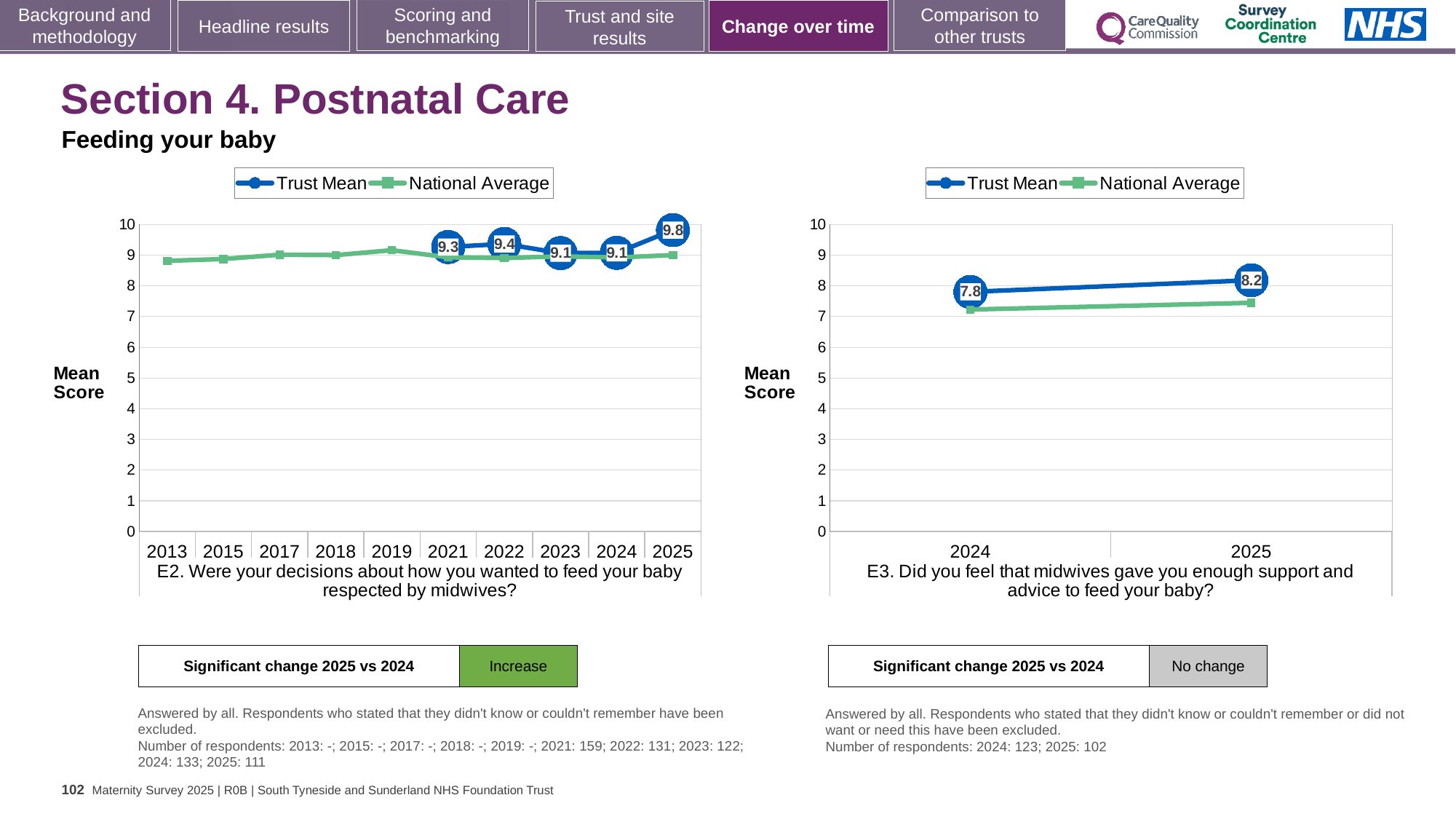
In the left chart (E2), which year has the highest Trust Mean? 2025 How many years are shown on the x axis of the left chart (E2)? 10 In the left chart (E2), what is the Trust Mean for 2025? 9.8 In the left chart (E2), what is the Trust Mean for 2021? 9.3 How many series does the legend of the right chart (E3) list? 2 In the right chart (E3), what is the difference between the Trust Mean in 2025 and in 2024? 0.4 In the right chart (E3), is the National Average for 2024 greater or less than 8? less In the right chart (E3), what is the Trust Mean for 2024? 7.8 In the left chart (E2), what is the difference between the Trust Mean in 2025 and in 2024? 0.7 What kind of chart is the right chart (E3)? Line chart In the right chart (E3), does the Trust Mean rise or fall from 2024 to 2025? Rise In the left chart (E2), which is larger, the Trust Mean for 2022 or for 2023? 2022